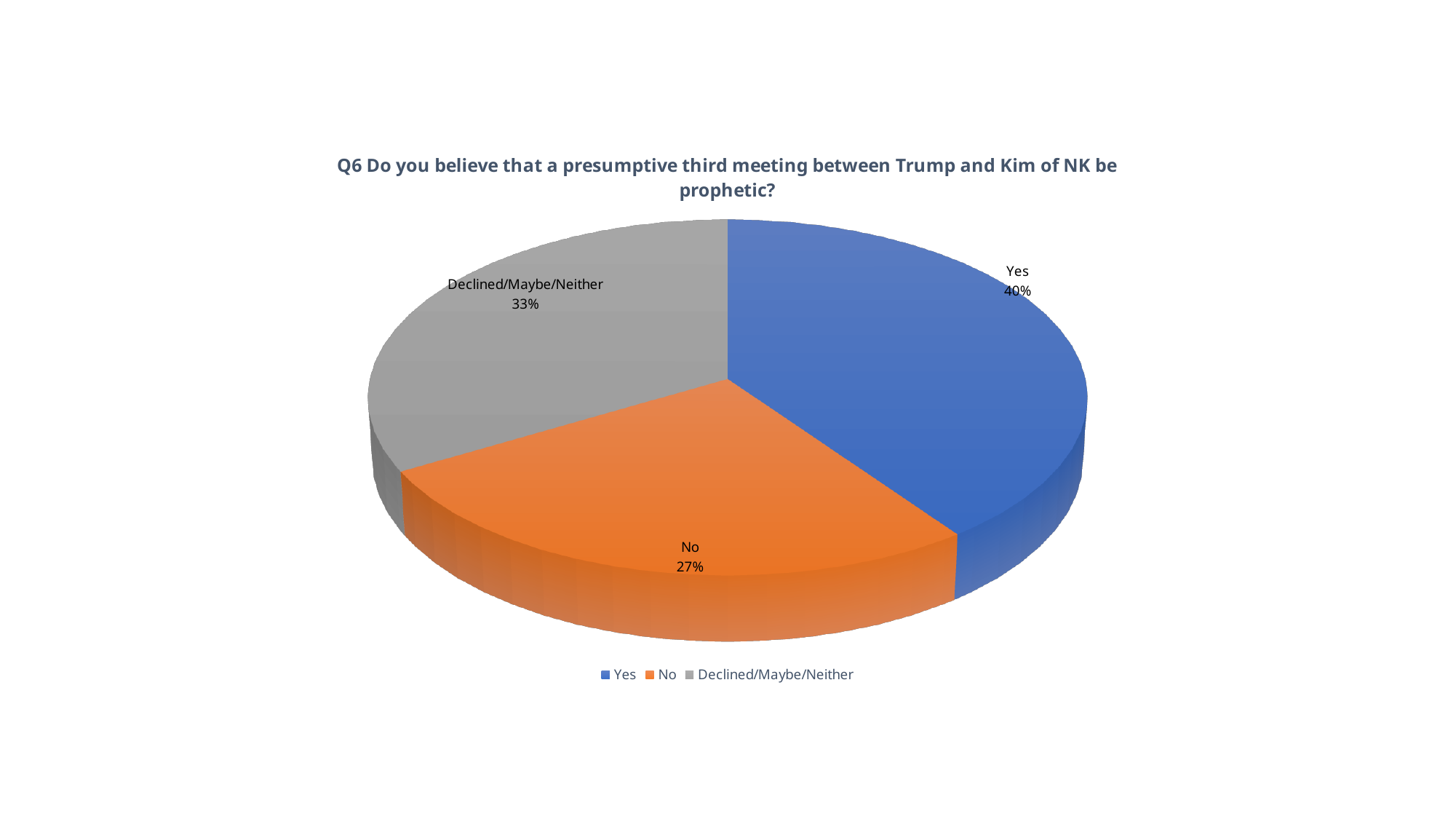
What kind of chart is shown on the slide? Pie chart Which response has the largest share of the pie? Yes Which response has the smallest share of the pie? No What percentage of respondents answered No? 27% Which is larger, the share for No or the share for Declined/Maybe/Neither? Declined/Maybe/Neither What percentage is shown for Declined/Maybe/Neither? 33% What is the difference in percentage points between Yes and Declined/Maybe/Neither? 7 What is the difference in percentage points between Yes and No? 13 What colour is the slice for No? Orange What percentage of respondents answered Yes? 40% How many entries does the legend list? 3 How many slices does the pie chart have? 3